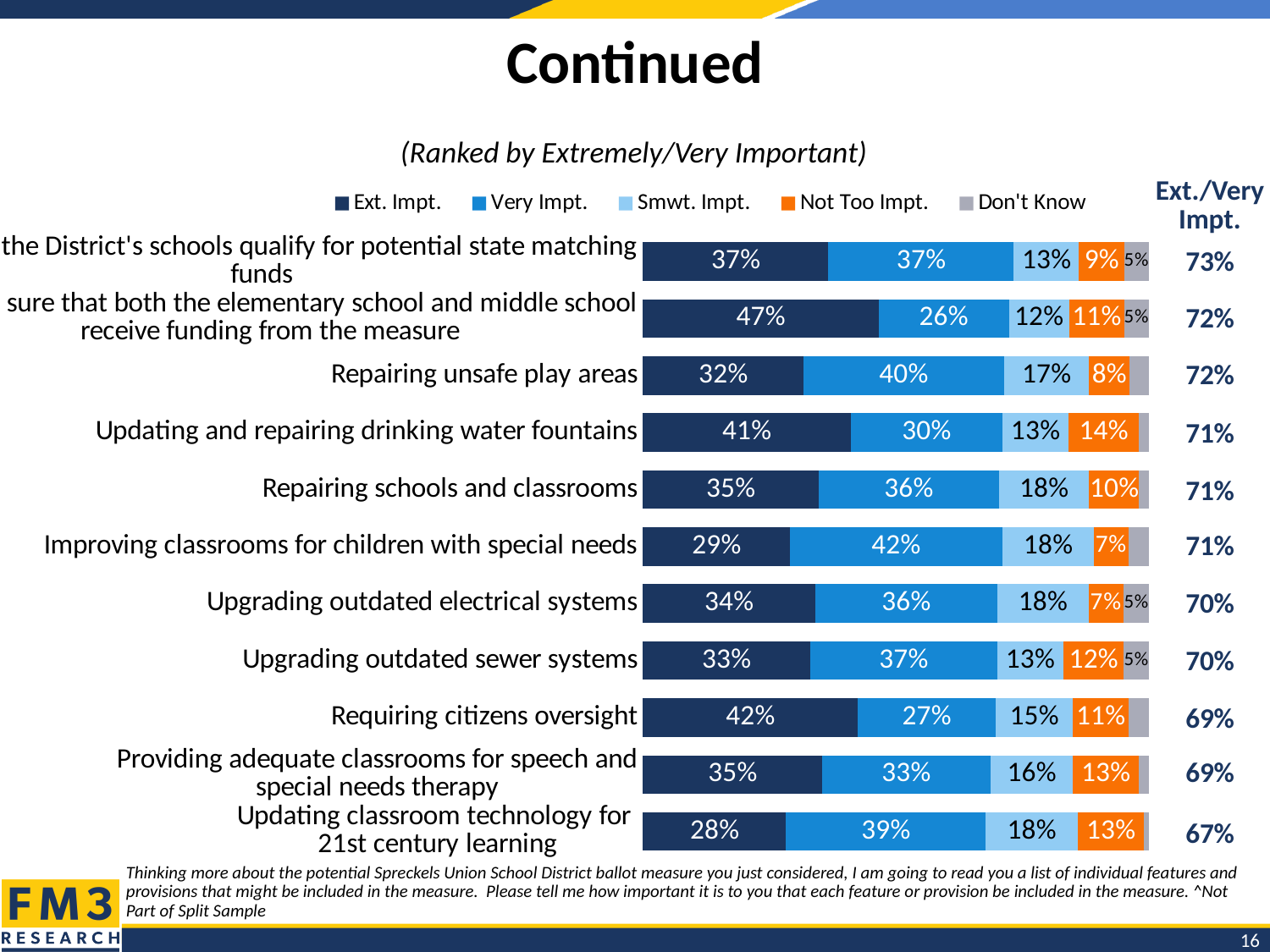
Which category has the lowest Ext./Very Impt. total? Updating classroom technology for 21st century learning What is the Not Too Impt. value for "Updating and repairing drinking water fountains"? 14% What is the subtitle shown above the chart legend? (Ranked by Extremely/Very Important) What is the Very Impt. value for "Repairing unsafe play areas"? 40% How many categories (bars) are plotted in the chart? 11 What is the Ext./Very Impt. total shown for "Updating classroom technology for 21st century learning"? 67% Which has a larger Not Too Impt. value: "Updating and repairing drinking water fountains" or "Repairing unsafe play areas"? Updating and repairing drinking water fountains What kind of chart is shown on the slide? Stacked bar chart What is the difference in Ext. Impt. between "Requiring citizens oversight" and "Repairing unsafe play areas"? 10 percentage points What is the Ext. Impt. value for "Requiring citizens oversight"? 42% Which category has the highest Very Impt. value? Improving classrooms for children with special needs How many series does the chart legend list? 5